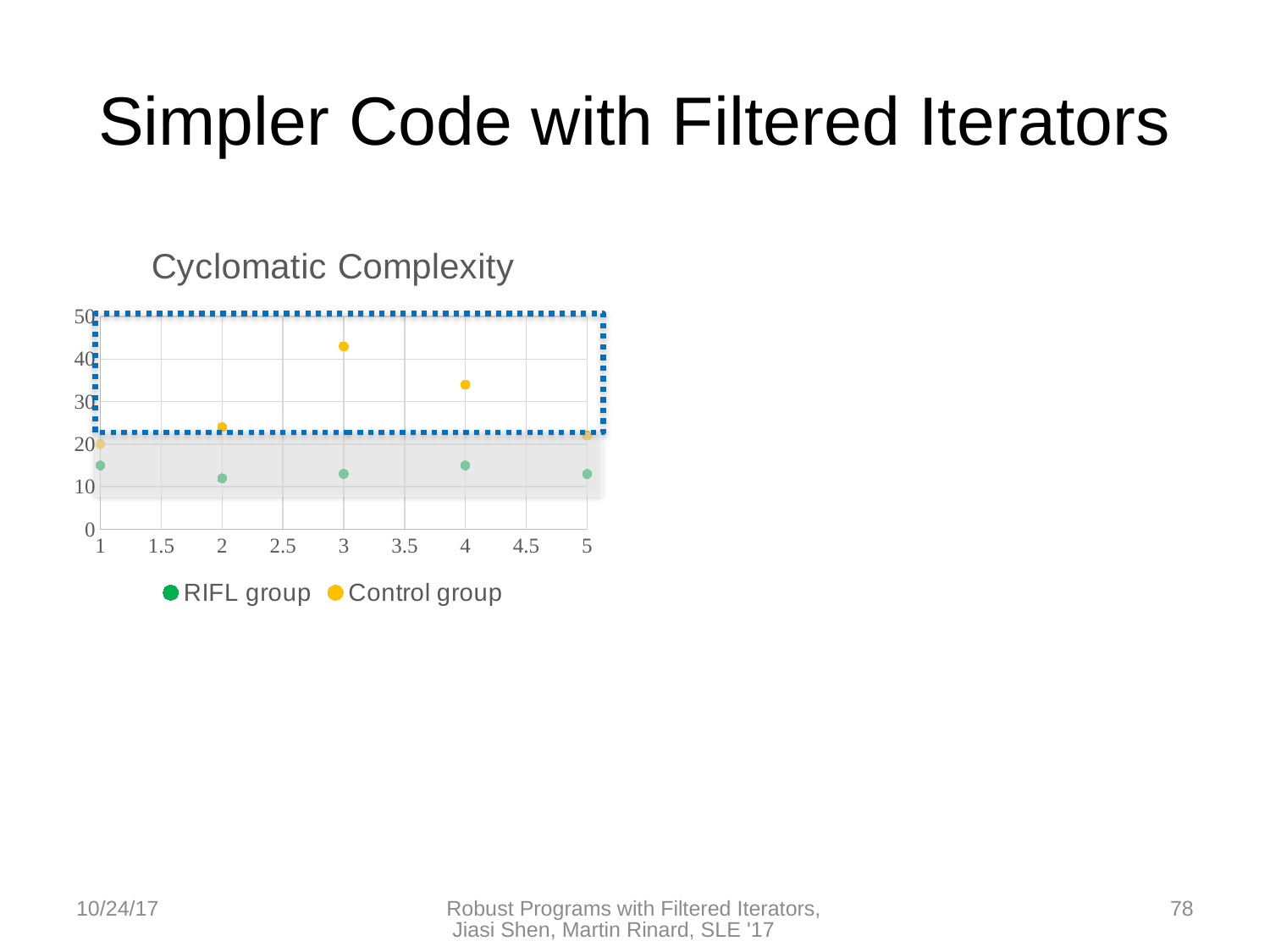
At which x value does the Control group reach its highest value? 3 What is the title of the chart? Cyclomatic Complexity Is the RIFL group value at x = 1 greater or less than 20? less Which series is shown in yellow? Control group Is the Control group value at x = 4 greater or less than 30? greater Is the RIFL group value at x = 2 greater or less than 20? less How many points are plotted for the Control group? 5 At x = 4, which series has the larger value, RIFL group or Control group? Control group At x = 3, which series has the larger value, RIFL group or Control group? Control group What kind of chart is shown on the slide? scatter chart How many series does the legend list? 2